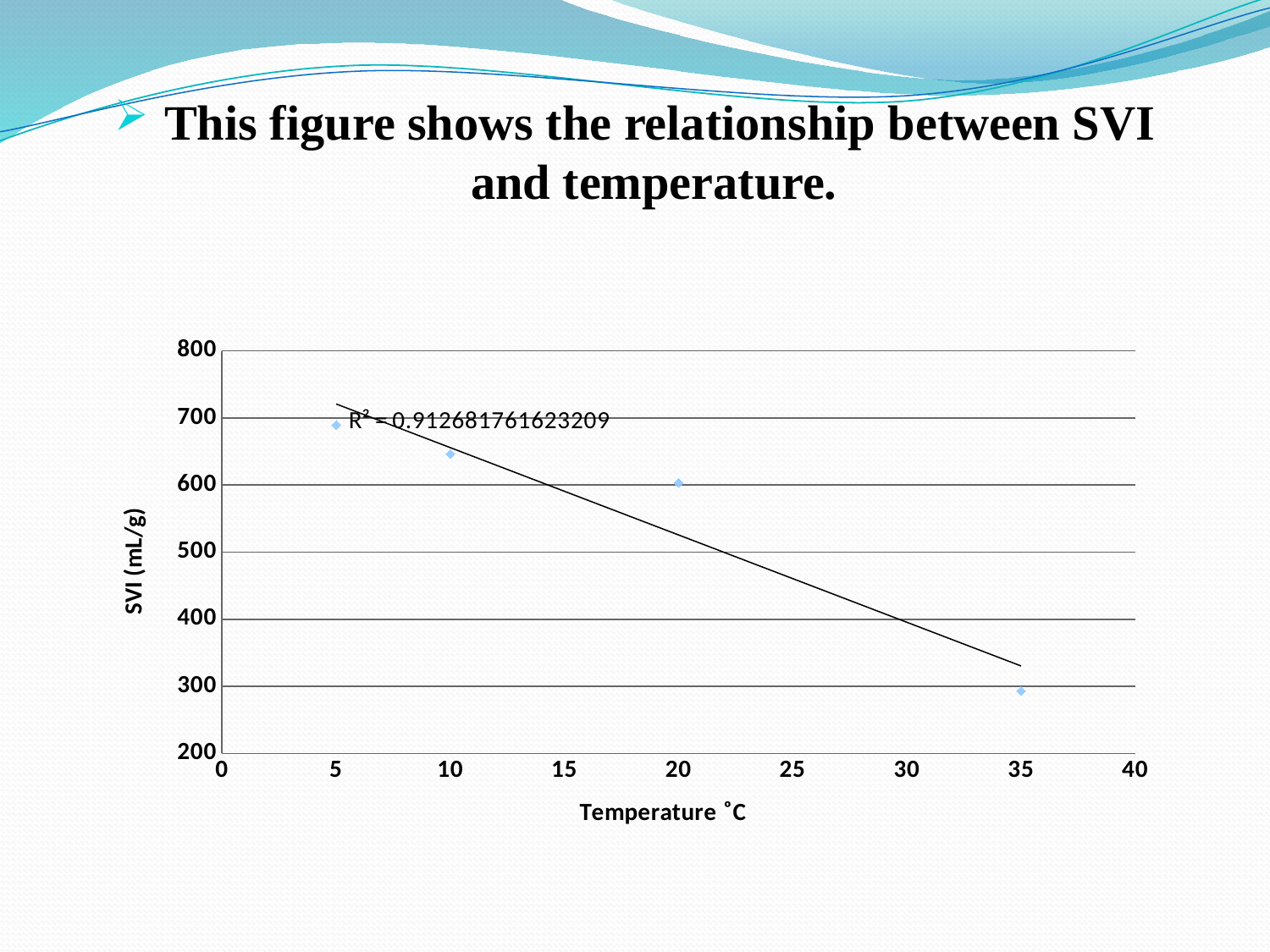
How many data points are plotted on the chart? 4 Is the SVI value at 10 °C greater or less than 700? less Which has the larger SVI value, the point at 10 °C or the point at 20 °C? 10 °C What kind of chart is shown on the slide? scatter chart What R² value is printed on the chart for the trendline? 0.912681761623209 At which temperature is the SVI value lowest? 35 Do the SVI values rise or fall as temperature increases along the x axis? fall At which temperature is the SVI value highest? 5 Is the SVI value at 5 °C greater or less than 600? greater What is the title of the vertical axis? SVI (mL/g) Is the SVI value at 20 °C greater or less than 500? greater